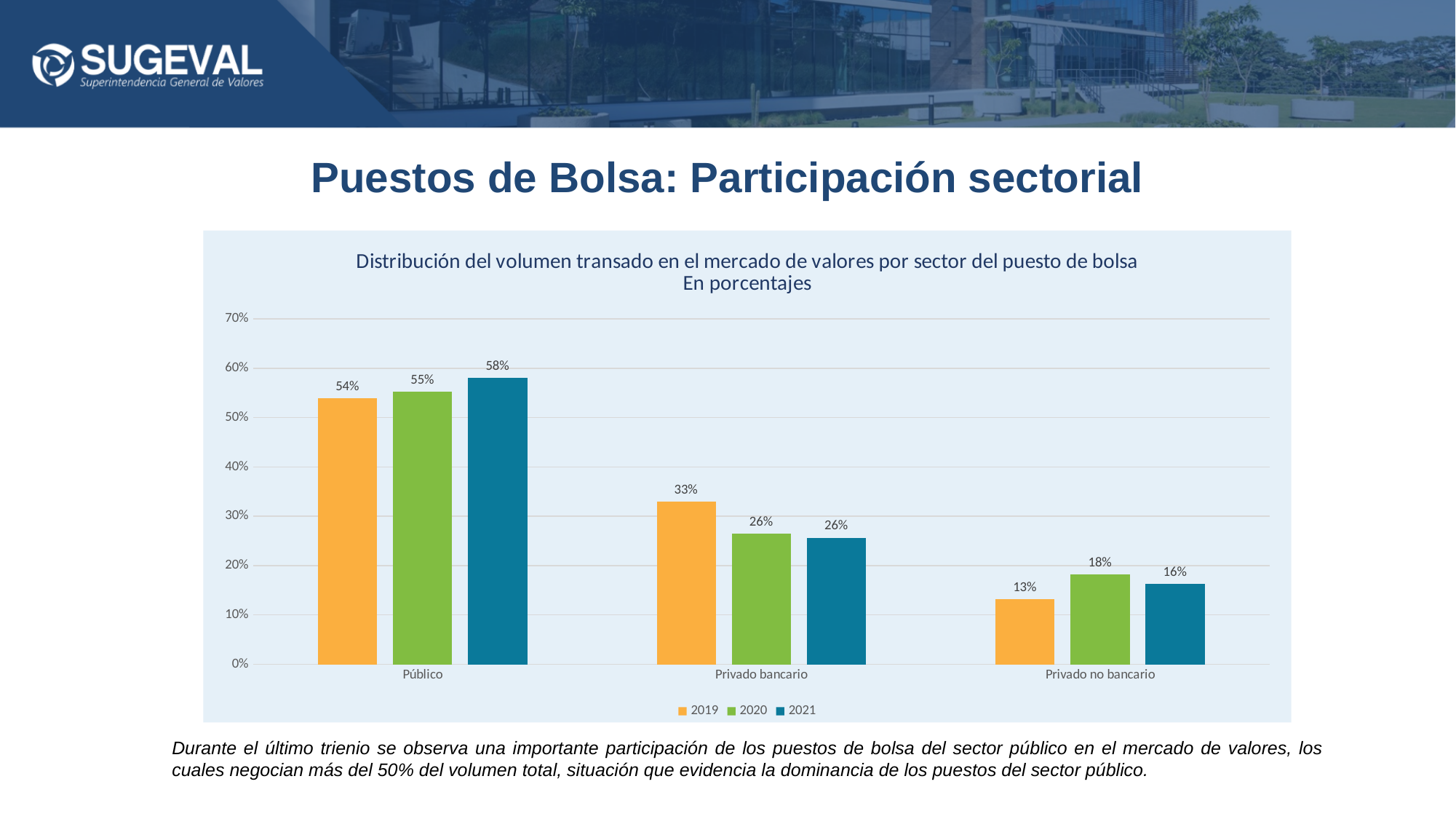
What kind of chart is shown? Bar chart Which series is shown in orange in the legend? 2019 What is the difference between the 2021 and 2019 values for Público? 4% Which category has the highest value in 2019? Público What is the value for Privado bancario in 2019? 33% Which is larger: Privado bancario in 2019 or Privado bancario in 2020? Privado bancario in 2019 How many series does the legend list? 3 Which category has the lowest value in 2021? Privado no bancario What is the value for Privado no bancario in 2020? 18% Do the values for Público rise or fall from 2019 to 2021? Rise How many categories are shown on the x axis? 3 What is the value for Público in 2021? 58%